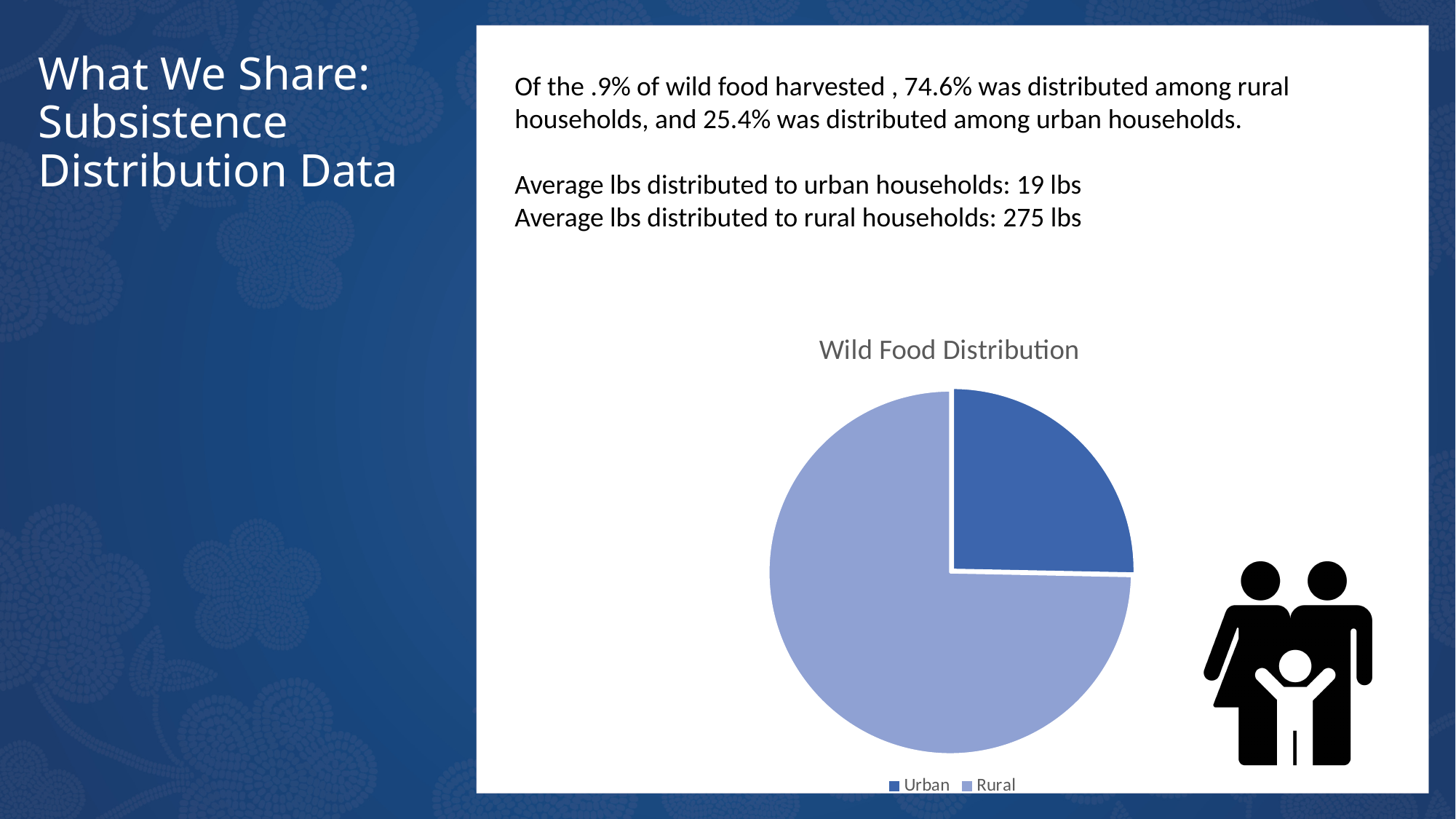
What kind of chart is shown on the slide? pie chart What share of the Wild Food Distribution pie does the Rural slice represent, according to the slide text? 74.6% What share of the Wild Food Distribution pie does the Urban slice represent, according to the slide text? 25.4% Which category has the smallest slice in the Wild Food Distribution pie chart? Urban In the Wild Food Distribution pie chart, which slice is larger, Urban or Rural? Rural Which category has the largest slice in the Wild Food Distribution pie chart? Rural How many entries does the legend of the Wild Food Distribution chart list? 2 How many slices does the Wild Food Distribution pie chart have? 2 Which legend entry in the Wild Food Distribution chart is shown in the darker blue colour? Urban What is the title of the chart? Wild Food Distribution